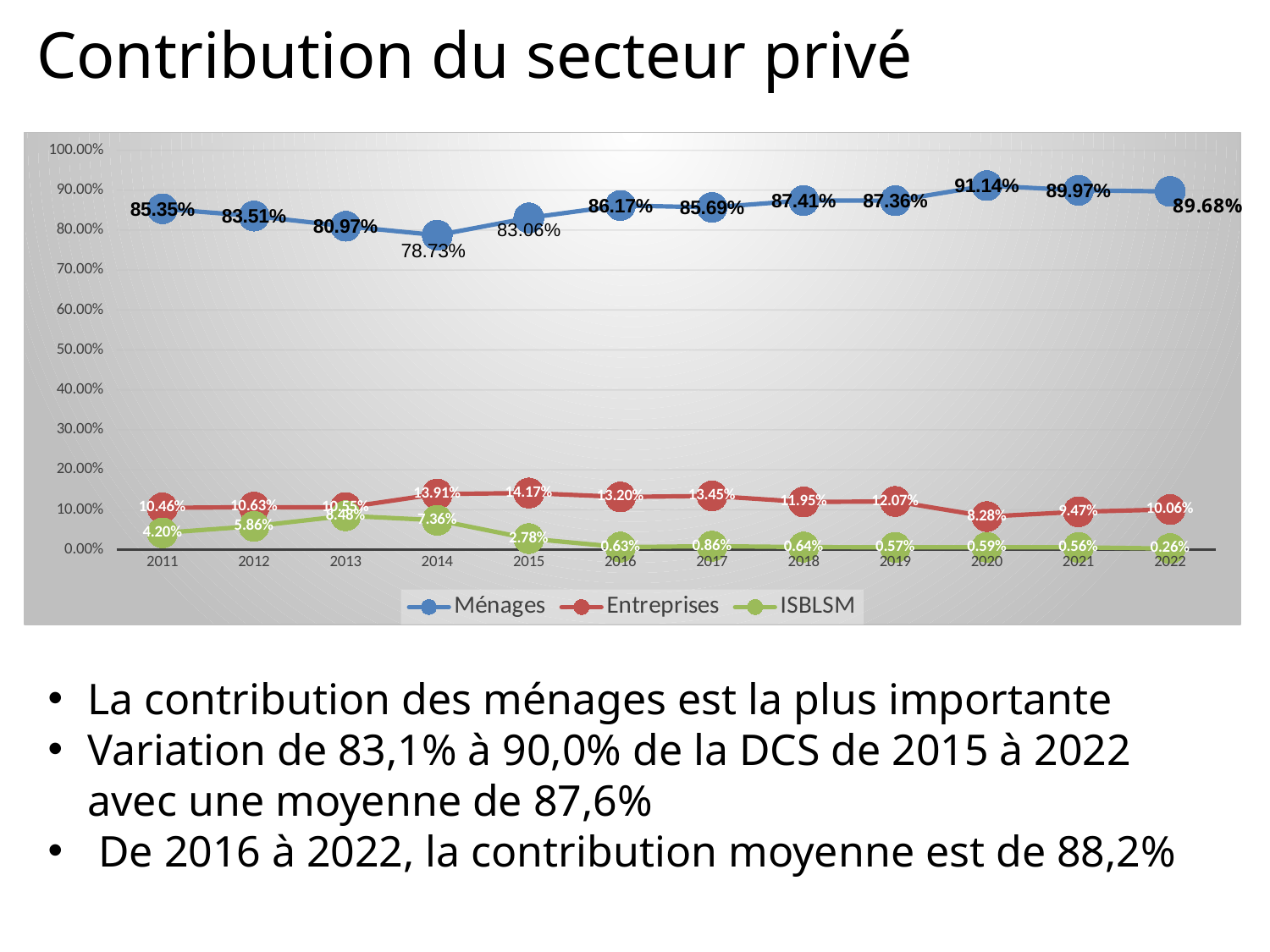
In which year is the Ménages value highest? 2020 Which is larger in 2020: the Entreprises value or the ISBLSM value? Entreprises Which series is plotted in blue? Ménages In which year is the ISBLSM value lowest? 2022 What is the difference between the Ménages values in 2020 and 2014? 12.41% What is the value for Entreprises in 2015? 14.17% What is the value for Ménages in 2014? 78.73% What type of chart is shown on the slide? line chart How many series does the legend list? 3 What is the value for ISBLSM in 2013? 8.48% In which year is the Ménages value lowest? 2014 How many years are shown on the x axis? 12